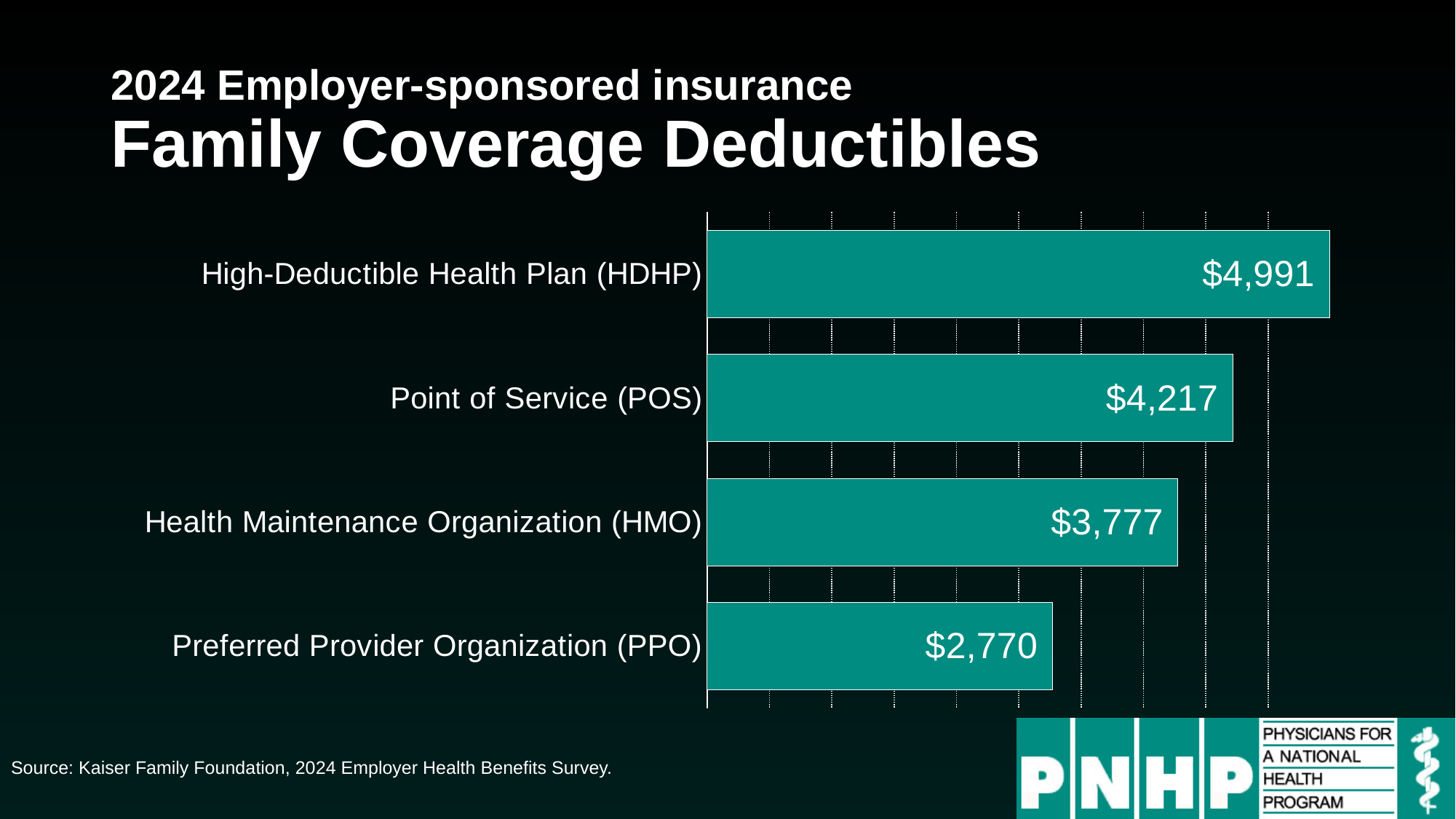
Which has a larger family coverage deductible, the POS plan or the HMO? Point of Service (POS) How many plan types are shown in the chart? 4 What is the family coverage deductible for the Preferred Provider Organization (PPO)? $2,770 How much higher is the HDHP deductible than the PPO deductible? $2,221 What is the family coverage deductible for the Health Maintenance Organization (HMO)? $3,777 Which plan type has the lowest family coverage deductible? Preferred Provider Organization (PPO) What kind of chart is shown on the slide? Bar chart What is the family coverage deductible for the Point of Service (POS) plan? $4,217 Which plan type has the highest family coverage deductible? High-Deductible Health Plan (HDHP) What is the family coverage deductible for the High-Deductible Health Plan (HDHP)? $4,991 What is the difference between the POS and HMO family coverage deductibles? $440 What is the source cited for the chart data? Kaiser Family Foundation, 2024 Employer Health Benefits Survey